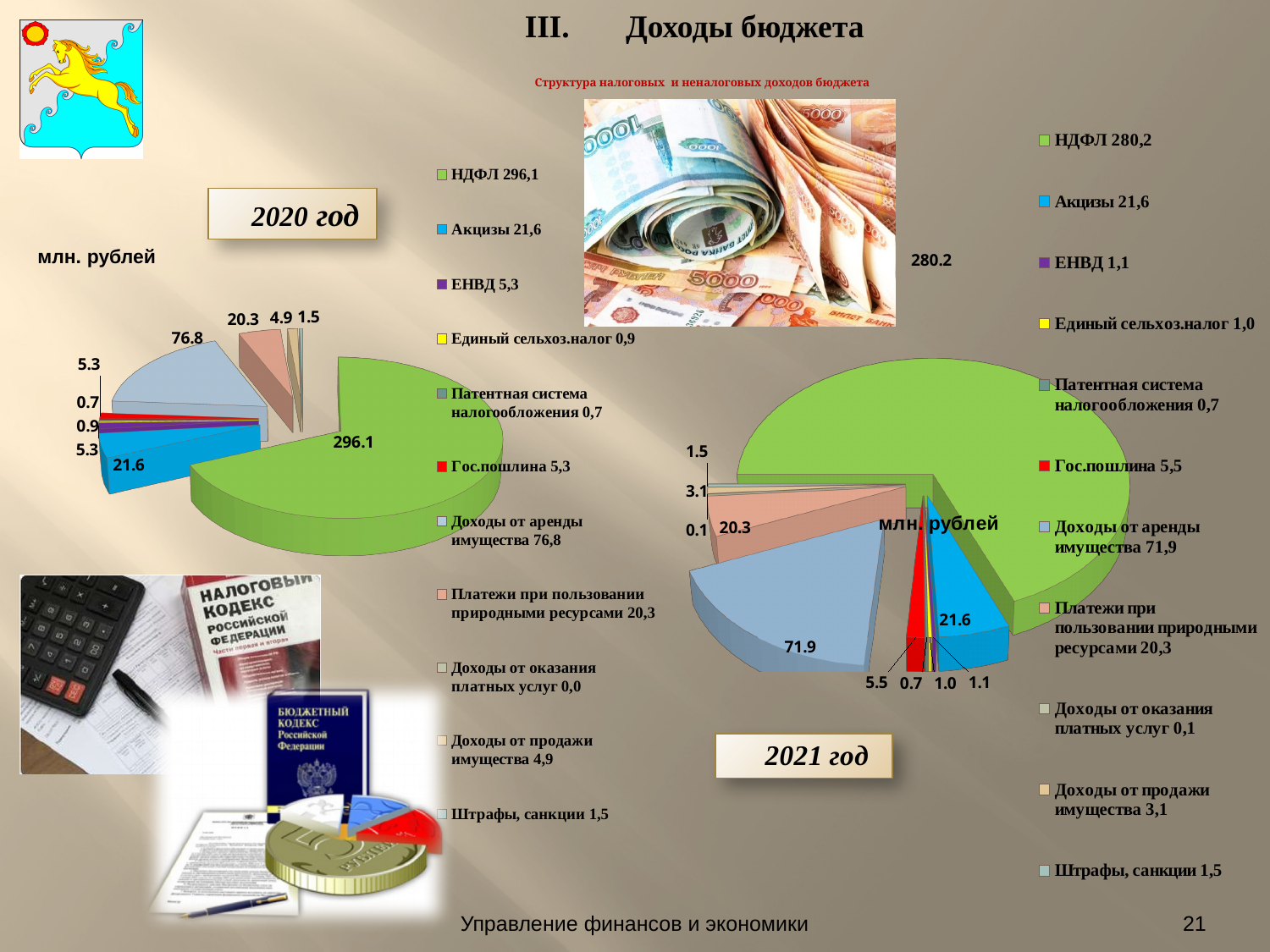
What kind of chart is the 2020 год chart? pie chart In the 2021 год chart, what is the value for Гос.пошлина? 5.5 How many categories does the legend of the 2020 год chart list? 11 How much larger is НДФЛ in the 2020 год chart than in the 2021 год chart? 15.9 In the 2021 год chart, what is the difference between Акцизы and Платежи при пользовании природными ресурсами? 1.3 In the 2021 год chart, which category has the largest value? НДФЛ In the 2020 год chart, which is larger: Доходы от аренды имущества or Платежи при пользовании природными ресурсами? Доходы от аренды имущества In the 2020 год chart, which category has the smallest value? Доходы от оказания платных услуг In the 2020 год chart, what is the value for НДФЛ? 296.1 In the 2021 год chart, what is the value for Доходы от аренды имущества? 71.9 In the 2020 год chart, what is the value for Доходы от продажи имущества? 4.9 In the 2021 год chart, what colour is the НДФЛ slice? green